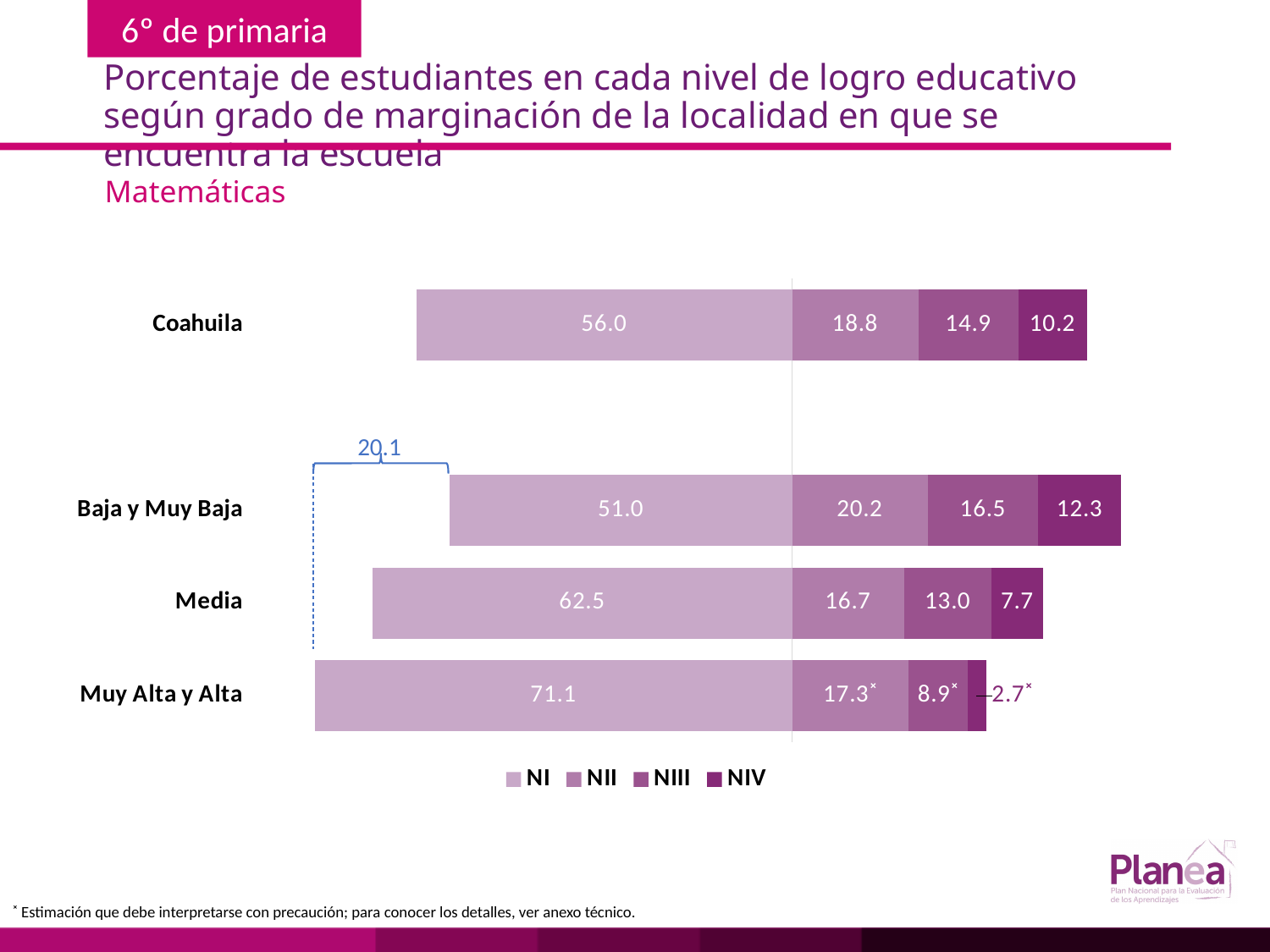
What is the NI value for Coahuila? 56.0 Which category has the highest NI value? Muy Alta y Alta What kind of chart is shown on the slide? Stacked bar chart Which is larger, the NIII value for Coahuila or the NIII value for Media? Coahuila How many series does the legend list? 4 What is the total of the stacked bar for Media? 99.9 What is the difference between the NI values for Muy Alta y Alta and Baja y Muy Baja? 20.1 Which category has the lowest NIV value? Muy Alta y Alta What is the NIII value for Muy Alta y Alta? 8.9 How many categories are shown on the chart? 4 What is the NII value for Media? 16.7 What is the NIV value for Baja y Muy Baja? 12.3